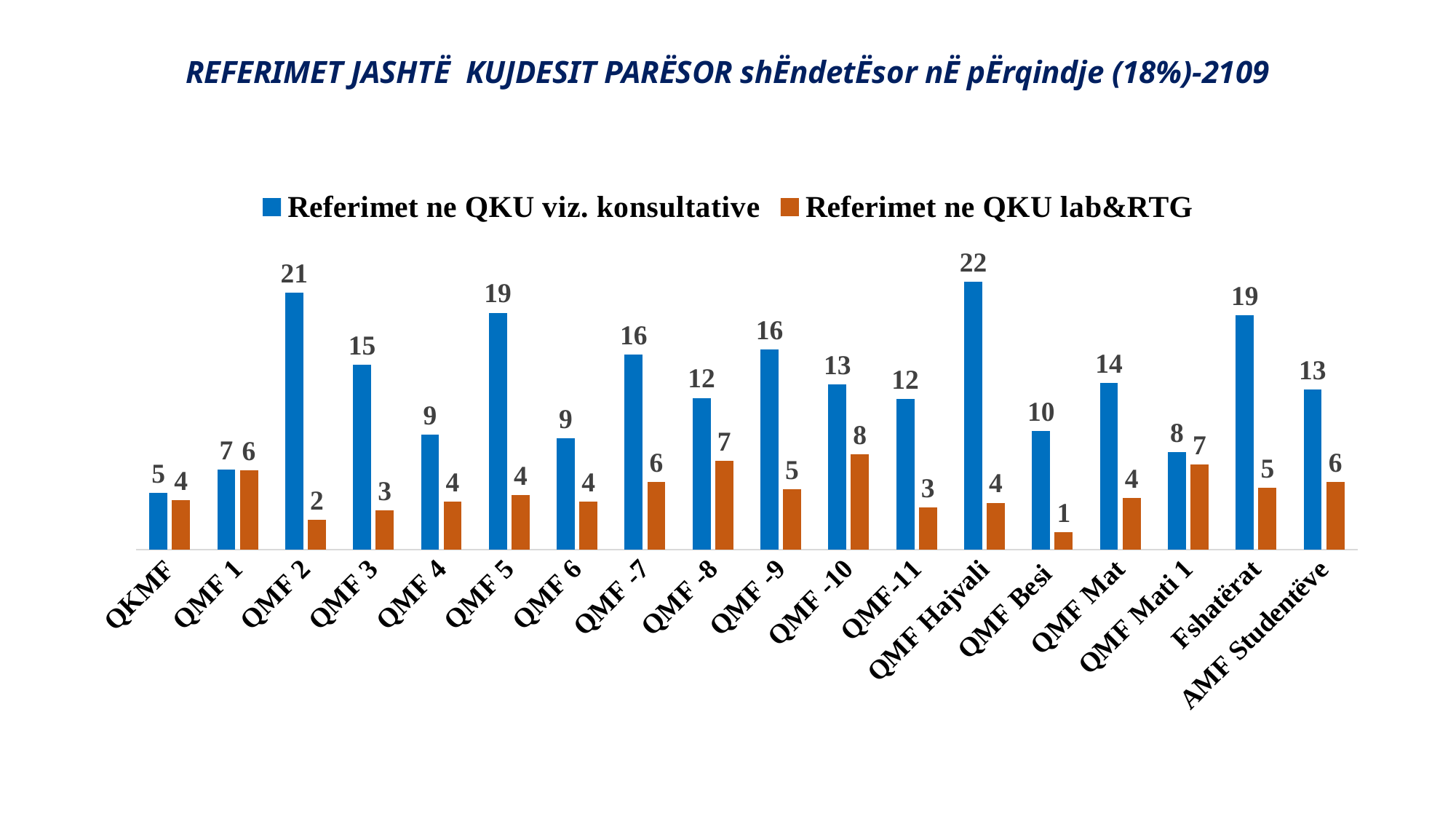
What colour represents Referimet ne QKU lab&RTG in the chart? Orange What is the difference between Referimet ne QKU viz. konsultative and Referimet ne QKU lab&RTG for QMF 2? 19 What is the value of Referimet ne QKU viz. konsultative for Fshatërat? 19 Which category has the lowest value for Referimet ne QKU viz. konsultative? QKMF Which is larger for QMF Mati 1: Referimet ne QKU viz. konsultative or Referimet ne QKU lab&RTG? Referimet ne QKU viz. konsultative Which category has the highest value for Referimet ne QKU viz. konsultative? QMF Hajvali Which category has the lowest value for Referimet ne QKU lab&RTG? QMF Besi What is the value of Referimet ne QKU lab&RTG for QMF -10? 8 How many series does the legend list? 2 What is the value of Referimet ne QKU viz. konsultative for QMF Hajvali? 22 How many categories are shown on the x axis? 18 What kind of chart is shown on the slide? Bar chart